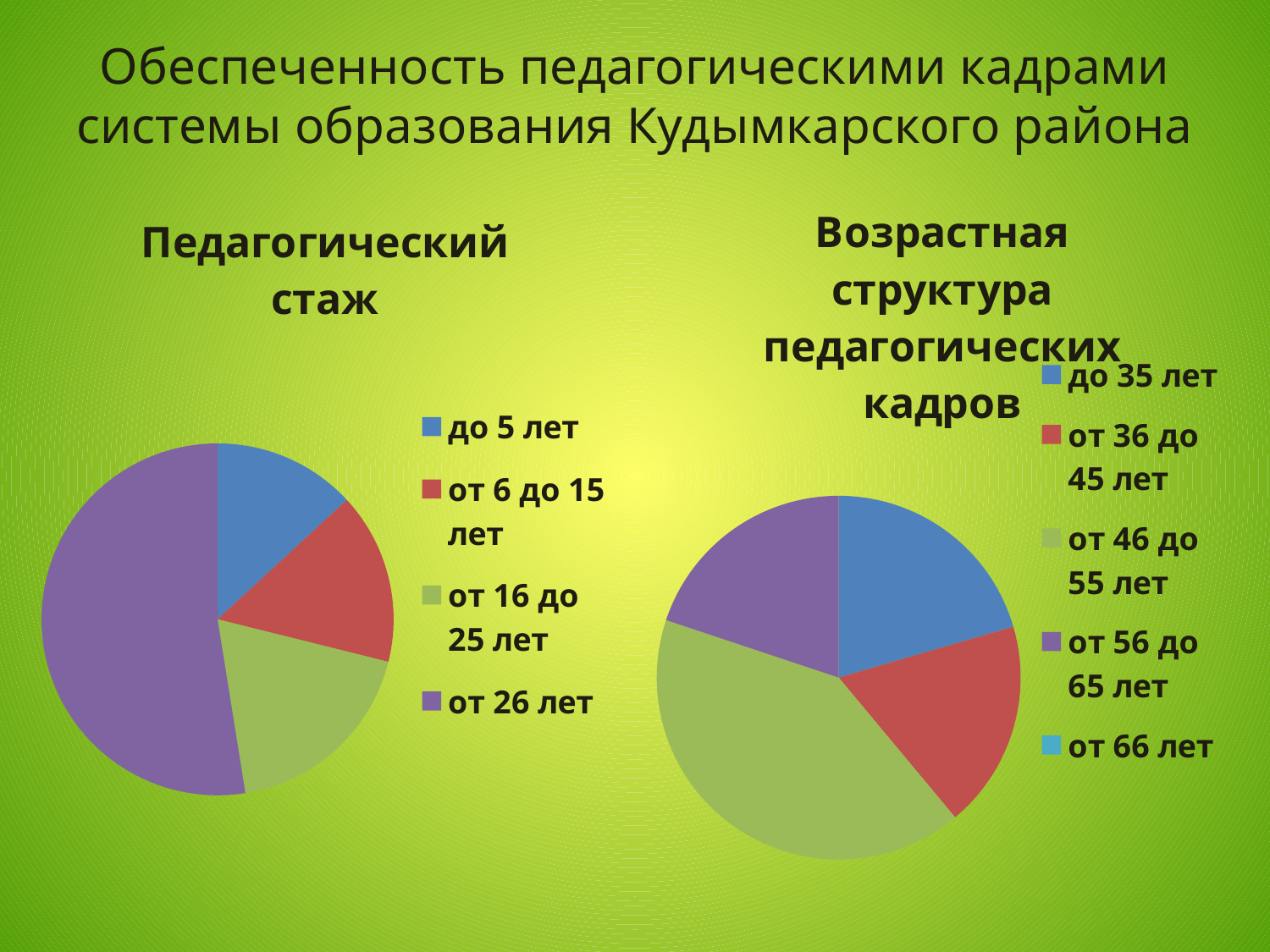
In the left chart "Педагогический стаж", which category has the smallest slice? до 5 лет How many categories does the legend of the right chart "Возрастная структура педагогических кадров" list? 5 In the left chart "Педагогический стаж", which category has the largest slice? от 26 лет How many categories does the legend of the left chart "Педагогический стаж" list? 4 In the right chart "Возрастная структура педагогических кадров", which slice is larger: "от 46 до 55 лет" or "до 35 лет"? от 46 до 55 лет What kind of chart is the right chart titled "Возрастная структура педагогических кадров"? pie chart What kind of chart is the left chart titled "Педагогический стаж"? pie chart In the right chart "Возрастная структура педагогических кадров", which category has the largest slice? от 46 до 55 лет What is the title of the chart on the right side of the slide? Возрастная структура педагогических кадров In the left chart "Педагогический стаж", what colour is the slice for "от 26 лет"? purple In the left chart "Педагогический стаж", which slice is larger: "от 26 лет" or "от 6 до 15 лет"? от 26 лет In the left chart "Педагогический стаж", which slice is larger: "до 5 лет" or "от 16 до 25 лет"? от 16 до 25 лет